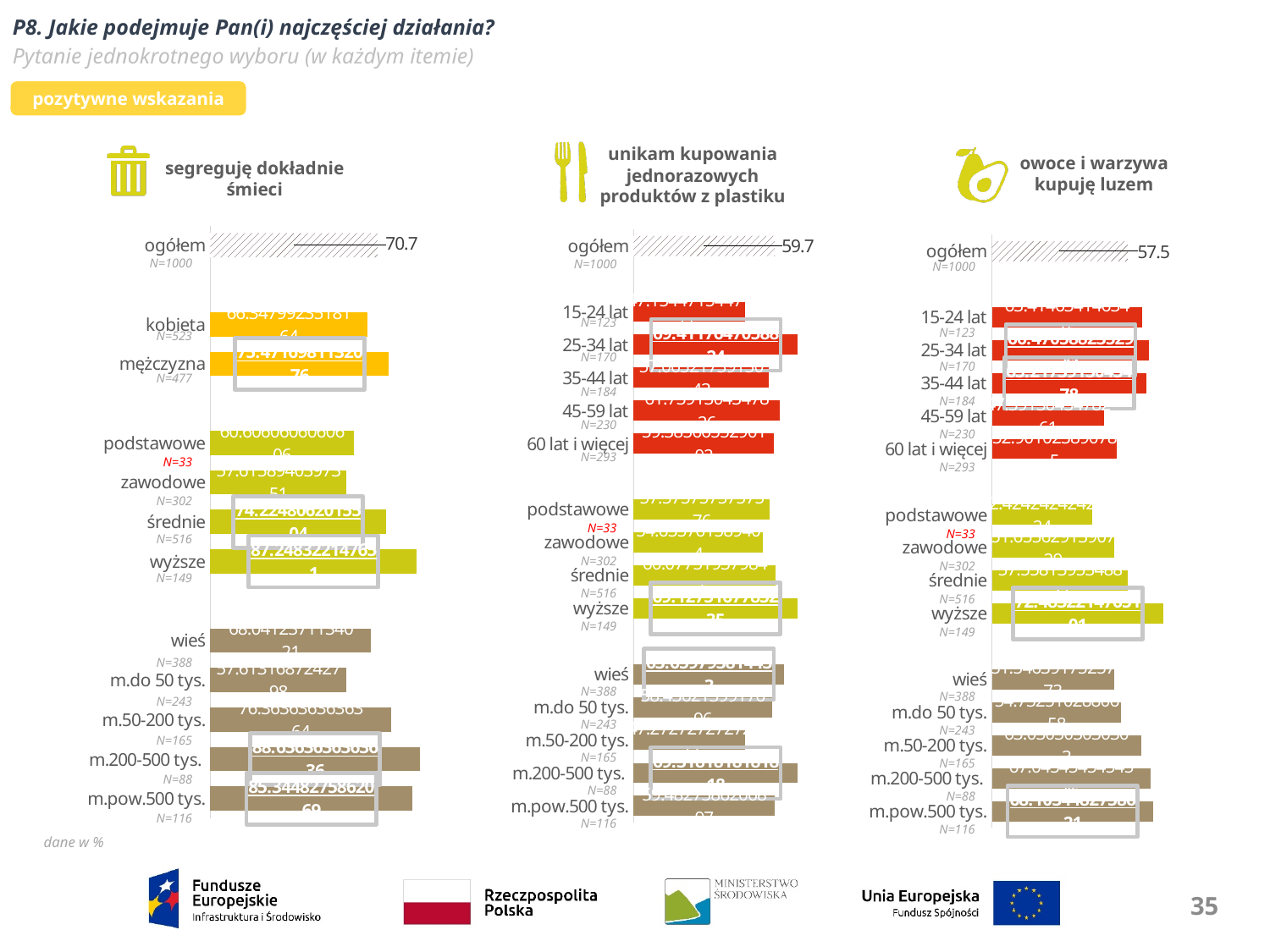
What kind of chart is used on this slide? bar chart On the chart titled 'segreguję dokładnie śmieci', which category has the longest bar? m.200-500 tys. On the chart titled 'unikam kupowania jednorazowych produktów z plastiku', what is the value for 'ogółem'? 59.7 On the chart titled 'segreguję dokładnie śmieci', which bar is longer: 'kobieta' or 'mężczyzna'? mężczyzna How many categories are plotted on the chart titled 'unikam kupowania jednorazowych produktów z plastiku'? 15 What is the difference between the 'ogółem' values of the 'segreguję dokładnie śmieci' chart and the 'owoce i warzywa kupuję luzem' chart? 13.2 On the chart titled 'owoce i warzywa kupuję luzem', which category has the longest bar? wyższe On the chart titled 'owoce i warzywa kupuję luzem', which bar is longer: '15-24 lat' or '60 lat i więcej'? 15-24 lat On the chart titled 'owoce i warzywa kupuję luzem', what is the value for 'ogółem'? 57.5 On the chart titled 'segreguję dokładnie śmieci', what is the value for 'ogółem'? 70.7 Which of the three charts has the highest 'ogółem' value? segreguję dokładnie śmieci On the chart titled 'owoce i warzywa kupuję luzem', which category has the shortest bar? podstawowe